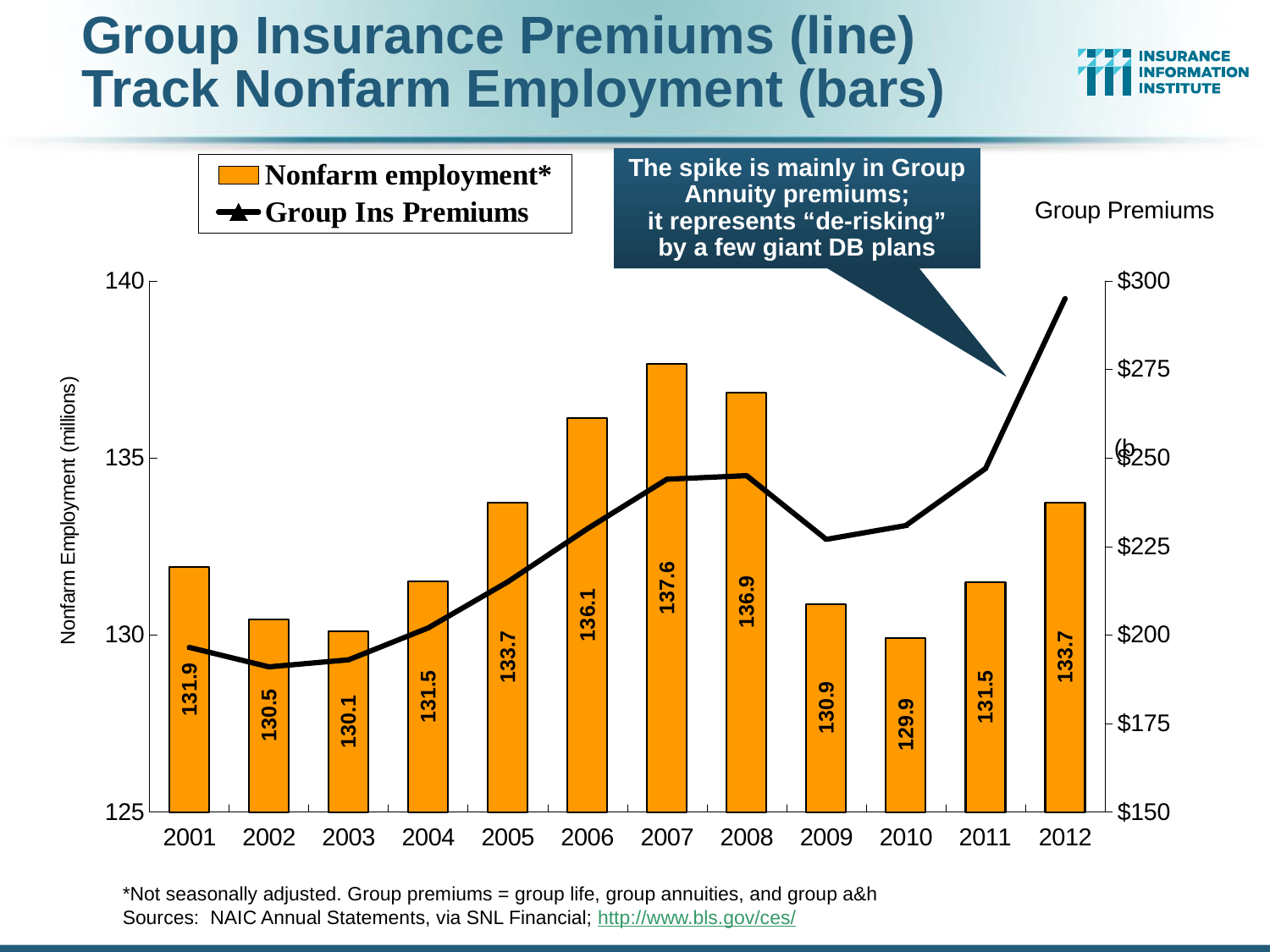
Which year has the larger nonfarm employment value, 2006 or 2008? 2008 How many years are shown on the x axis of the chart? 12 What is the difference between the nonfarm employment values for 2007 and 2010? 7.7 Does the Group Ins Premiums line rise or fall from 2009 to 2012? Rise How many series does the legend list? 2 What is the nonfarm employment value shown for 2010? 129.9 Which year has the lowest nonfarm employment bar? 2010 What kind of chart is this? Combined bar and line chart Which year has the highest nonfarm employment bar? 2007 What is the nonfarm employment value (in millions) shown for 2007? 137.6 Is the Group Ins Premiums value for 2002 greater or less than $200? less Is the Group Ins Premiums value for 2012 greater or less than $275? greater